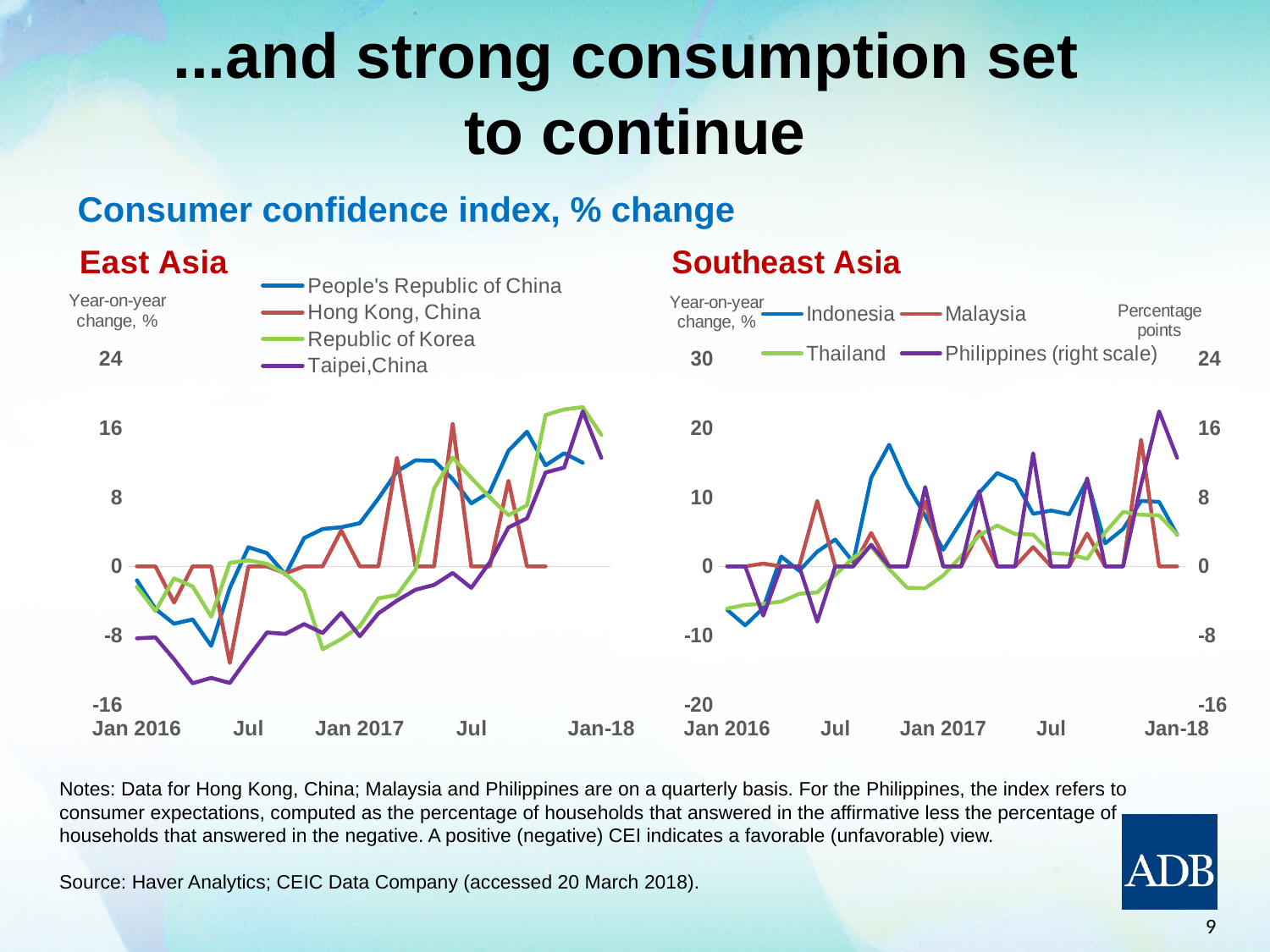
In the East Asia chart, is the lowest value for Taipei,China greater or less than -8? less What kind of chart is the East Asia chart? line chart How many series does the legend of the East Asia chart list? 4 In the East Asia chart, does the Republic of Korea series overall rise or fall from Jan 2016 to Jan-18? rise In the Southeast Asia chart, which series is plotted on the right scale? Philippines What is the title shown above the two charts? Consumer confidence index, % change In the Southeast Asia chart, is the value for Thailand at Jan 2016 greater or less than 0? less In the East Asia chart, is the highest value for Republic of Korea greater or less than 16? greater In the East Asia chart, does the Taipei,China series overall rise or fall from Jan 2016 to Jan-18? rise How many series does the legend of the Southeast Asia chart list? 4